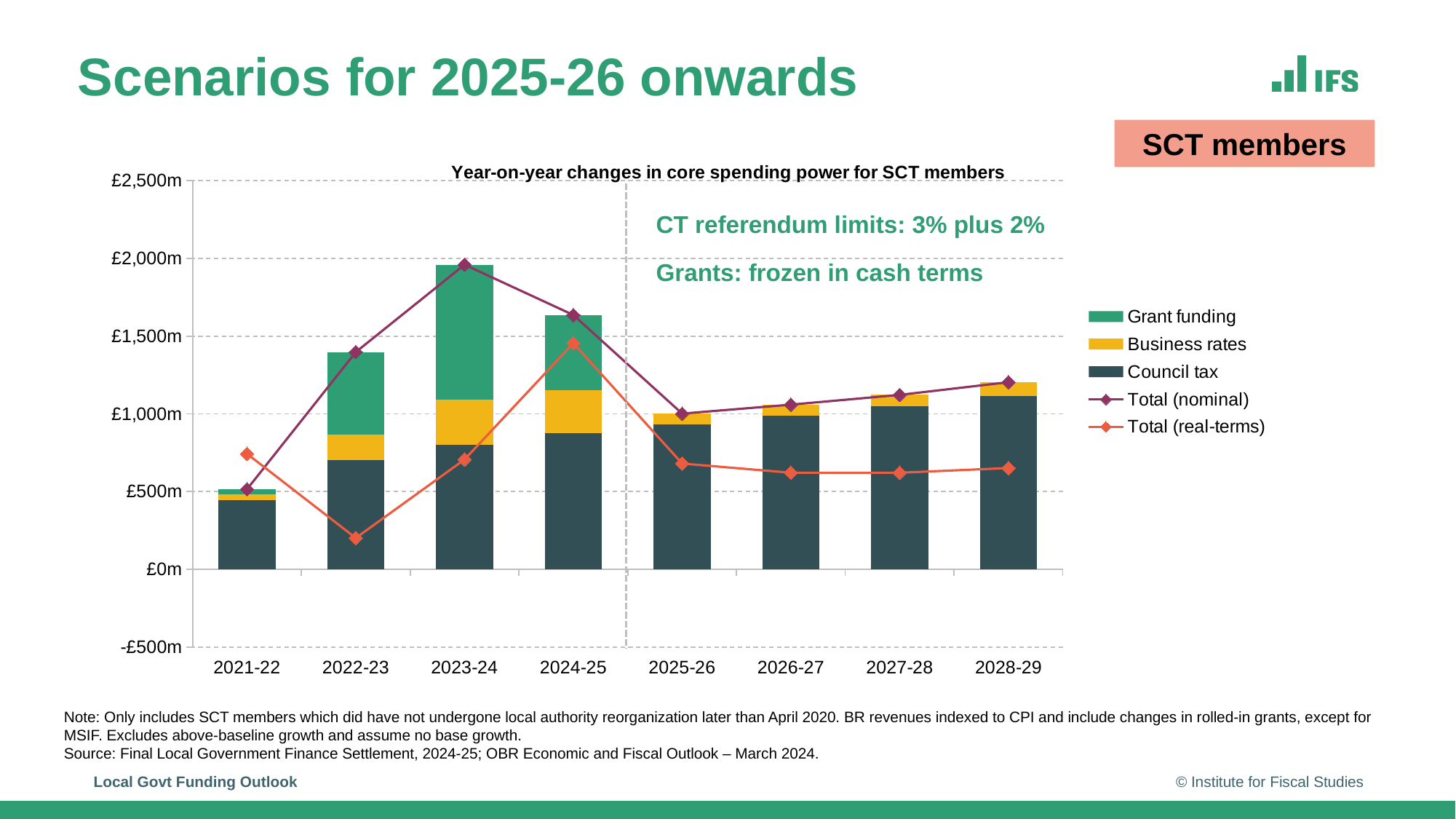
From 2025-26 to 2028-29, does Total (nominal) rise or fall? rise What is the title of the chart? Year-on-year changes in core spending power for SCT members Is the Total (nominal) value for 2023-24 greater or less than £1,500m? greater Is the Total (real-terms) value for 2022-23 greater or less than £500m? less In which year is Total (nominal) lowest? 2021-22 How many years are shown along the x axis? 8 Which is larger, Total (nominal) in 2022-23 or Total (nominal) in 2024-25? 2024-25 In which year is Total (real-terms) lowest? 2022-23 In which year is Total (real-terms) highest? 2024-25 In which year is Total (nominal) highest? 2023-24 How many series does the legend list? 5 What kind of chart is shown on the slide? combination bar and line chart (stacked bars with lines)